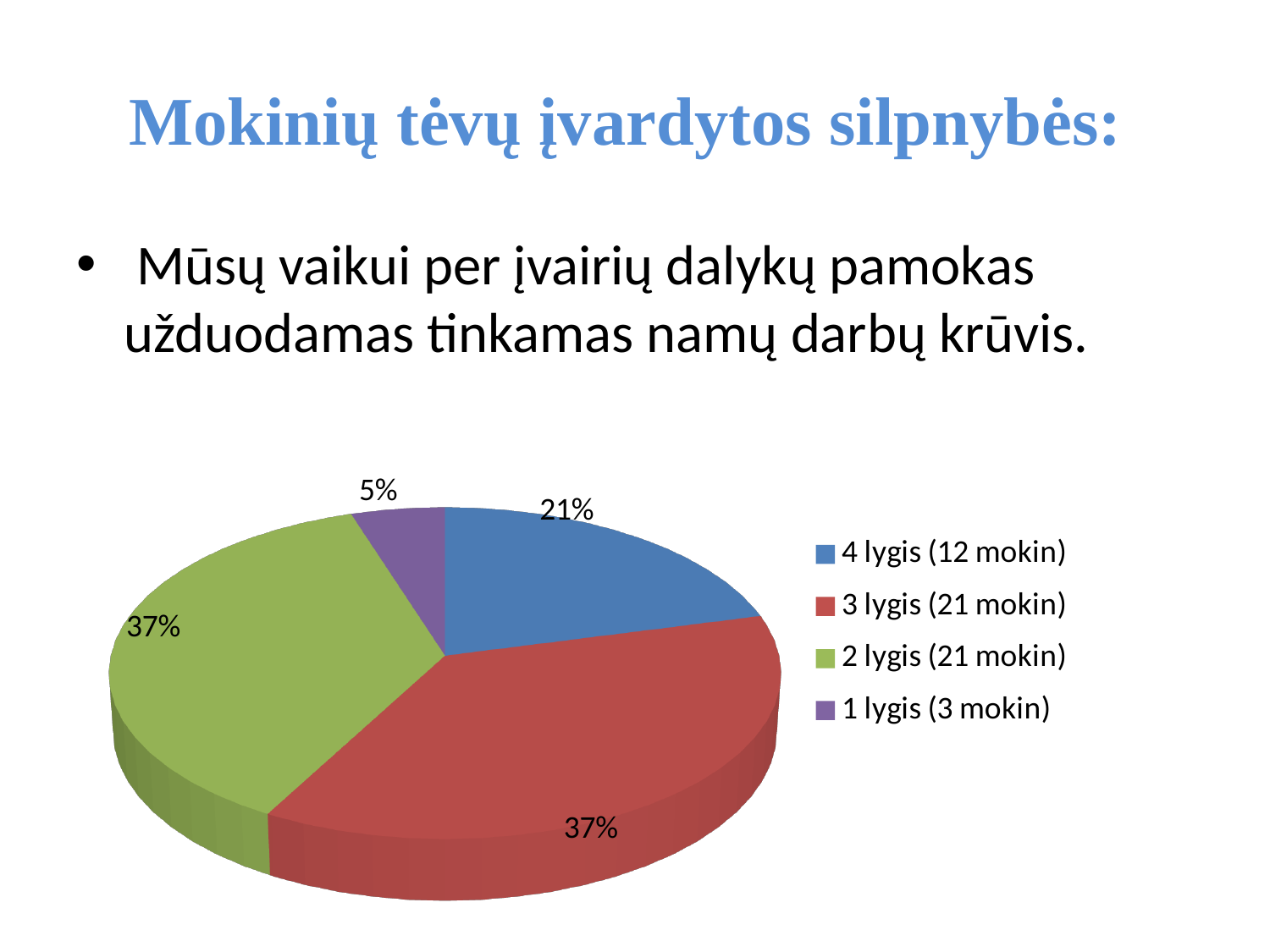
Which slice is larger, "4 lygis (12 mokin)" or "1 lygis (3 mokin)"? 4 lygis (12 mokin) What kind of chart is shown on the slide? pie chart What share of the pie does "1 lygis (3 mokin)" represent? 5% How many entries does the legend list? 4 What colour is the slice for "2 lygis (21 mokin)"? green What share of the pie does "3 lygis (21 mokin)" represent? 37% Which legend entry is shown in blue? 4 lygis (12 mokin) How many slices does the pie chart have? 4 What share of the pie does "2 lygis (21 mokin)" represent? 37% What is the difference in percentage points between the "3 lygis (21 mokin)" slice and the "4 lygis (12 mokin)" slice? 16 Which category has the smallest slice of the pie? 1 lygis (3 mokin)